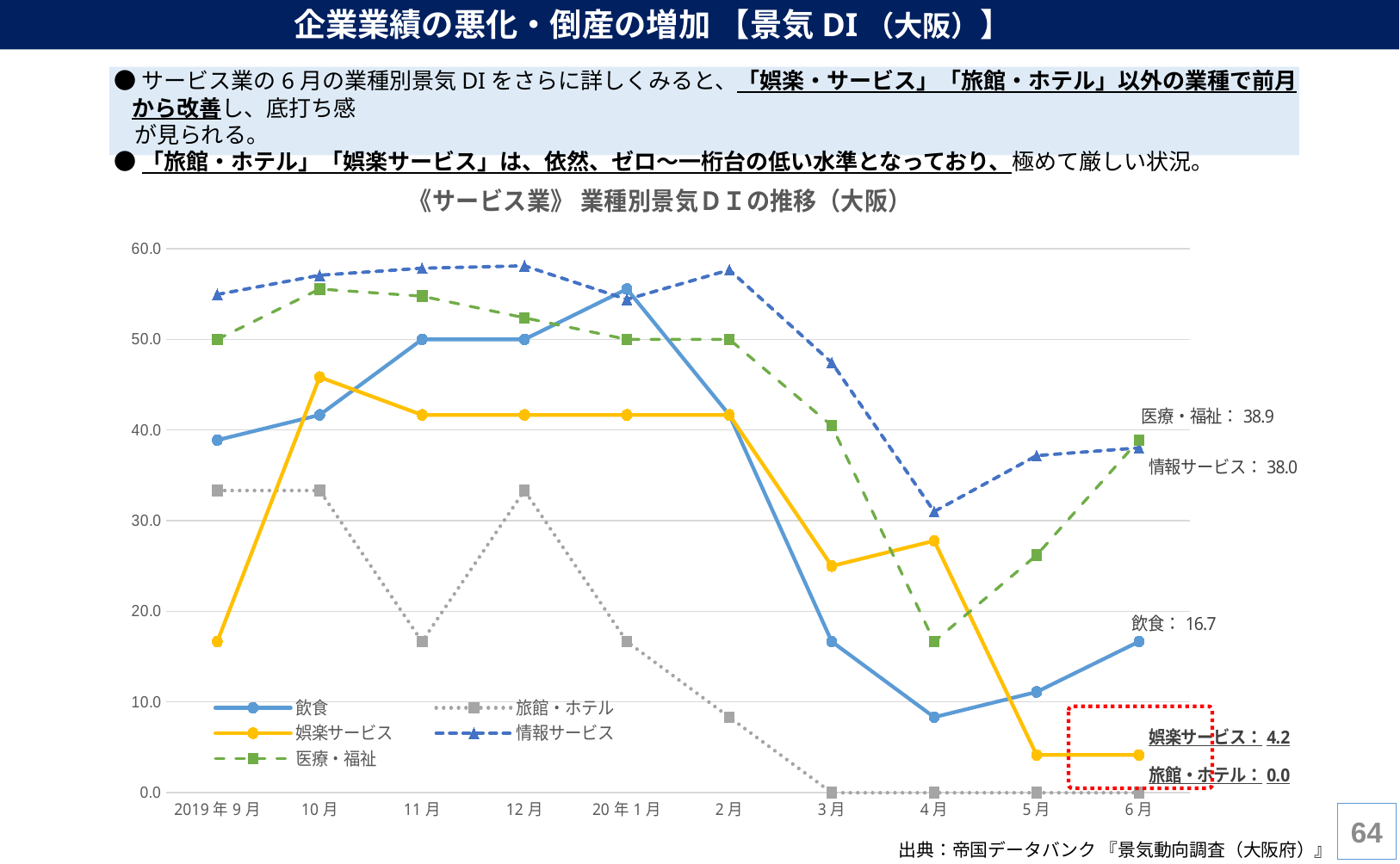
What kind of chart is this? line chart Is the value for 情報サービス in 2019年9月 greater or less than 50.0? greater How many series does the legend list? 5 What is the value for 娯楽サービス in 6月? 4.2 What is the value for 医療・福祉 in 6月? 38.9 What is the value for 旅館・ホテル in 6月? 0.0 Which series has the lowest value in 6月? 旅館・ホテル In 4月, which is larger: 情報サービス or 医療・福祉? 情報サービス What is the value for 情報サービス in 6月? 38.0 What is the value for 飲食 in 6月? 16.7 What is the difference between 飲食 and 娯楽サービス in 6月? 12.5 How many months are shown on the x axis? 10